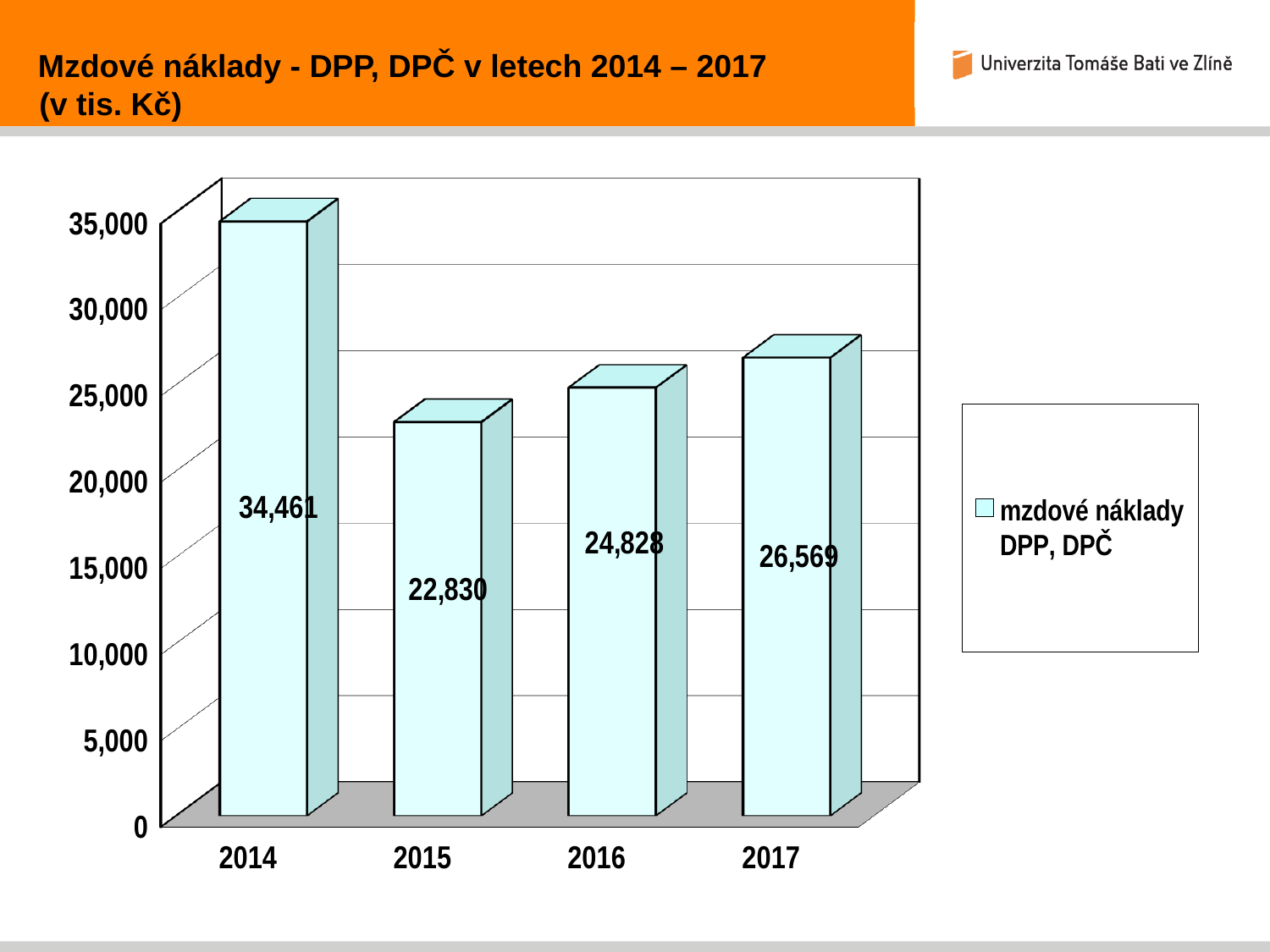
What is the difference between the values for 2014 and 2015? 11,631 What is the value for 2017? 26,569 What is the value for 2015? 22,830 What is the value for 2014? 34,461 How many years are shown on the x axis? 4 What series name does the legend list? mzdové náklady DPP, DPČ Which is larger, the value for 2016 or the value for 2017? 2017 Which year has the highest value? 2014 What is the difference between the values for 2017 and 2016? 1,741 What kind of chart is shown on the slide? bar chart What is the value for 2016? 24,828 Which year has the lowest value? 2015